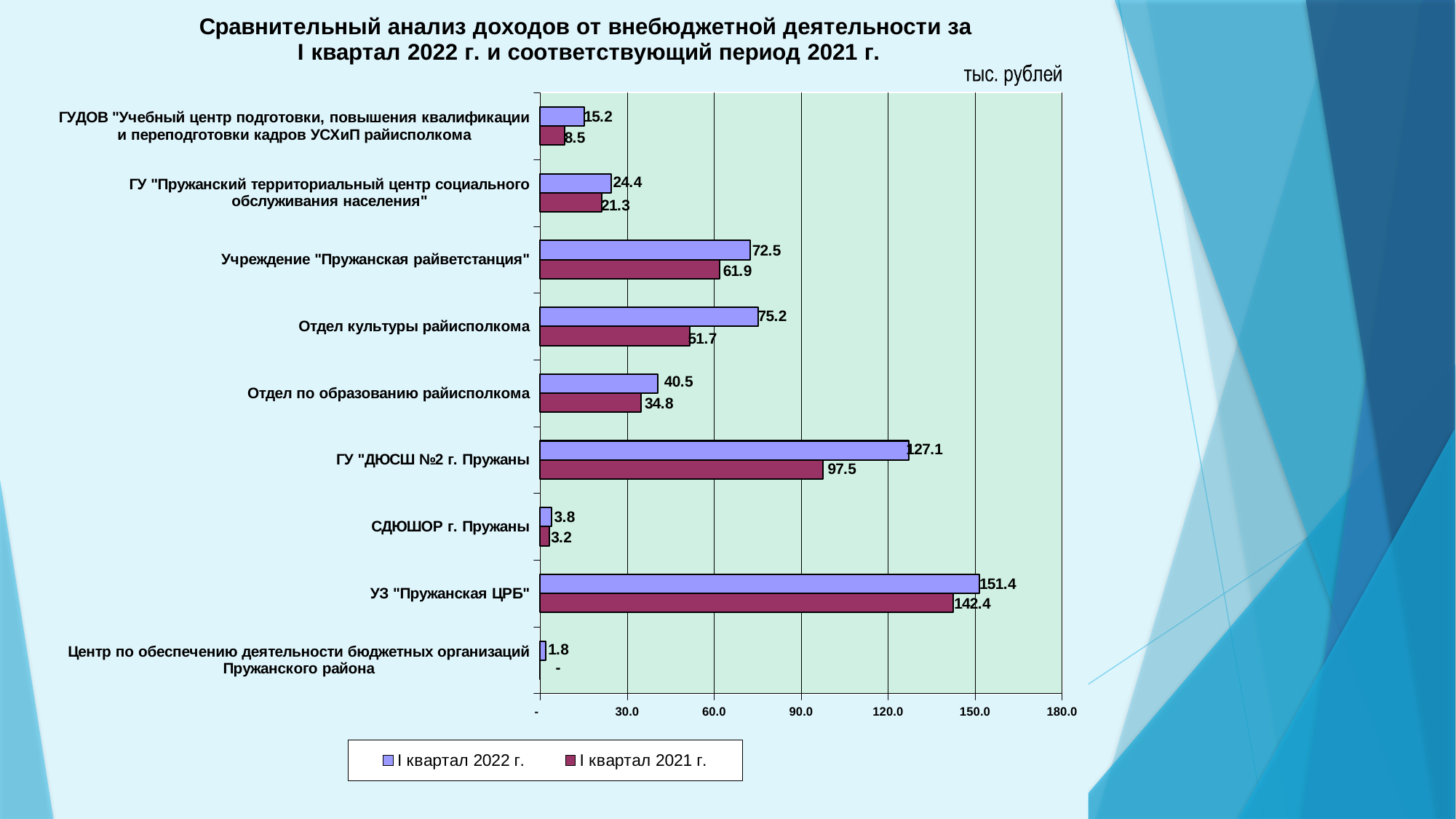
What is the value for Отдел культуры райисполкома in the I квартал 2021 г. series? 51.7 What unit of measurement is indicated above the chart? тыс. рублей How many series does the legend list? 2 What kind of chart is shown on the slide? bar chart How many categories (organisations) are shown on the chart? 9 Which category has the lowest value in the I квартал 2022 г. series? Центр по обеспечению деятельности бюджетных организаций Пружанского района What is the value for ГУ "ДЮСШ №2 г. Пружаны" in the I квартал 2021 г. series? 97.5 What is the value for УЗ "Пружанская ЦРБ" in the I квартал 2022 г. series? 151.4 Is the I квартал 2021 г. value for УЗ "Пружанская ЦРБ" greater or less than 120.0? greater Which is larger for Учреждение "Пружанская райветстанция": the I квартал 2022 г. value or the I квартал 2021 г. value? I квартал 2022 г. What is the difference between the I квартал 2022 г. and I квартал 2021 г. values for ГУ "ДЮСШ №2 г. Пружаны"? 29.6 Which category has the highest value in the I квартал 2022 г. series? УЗ "Пружанская ЦРБ"